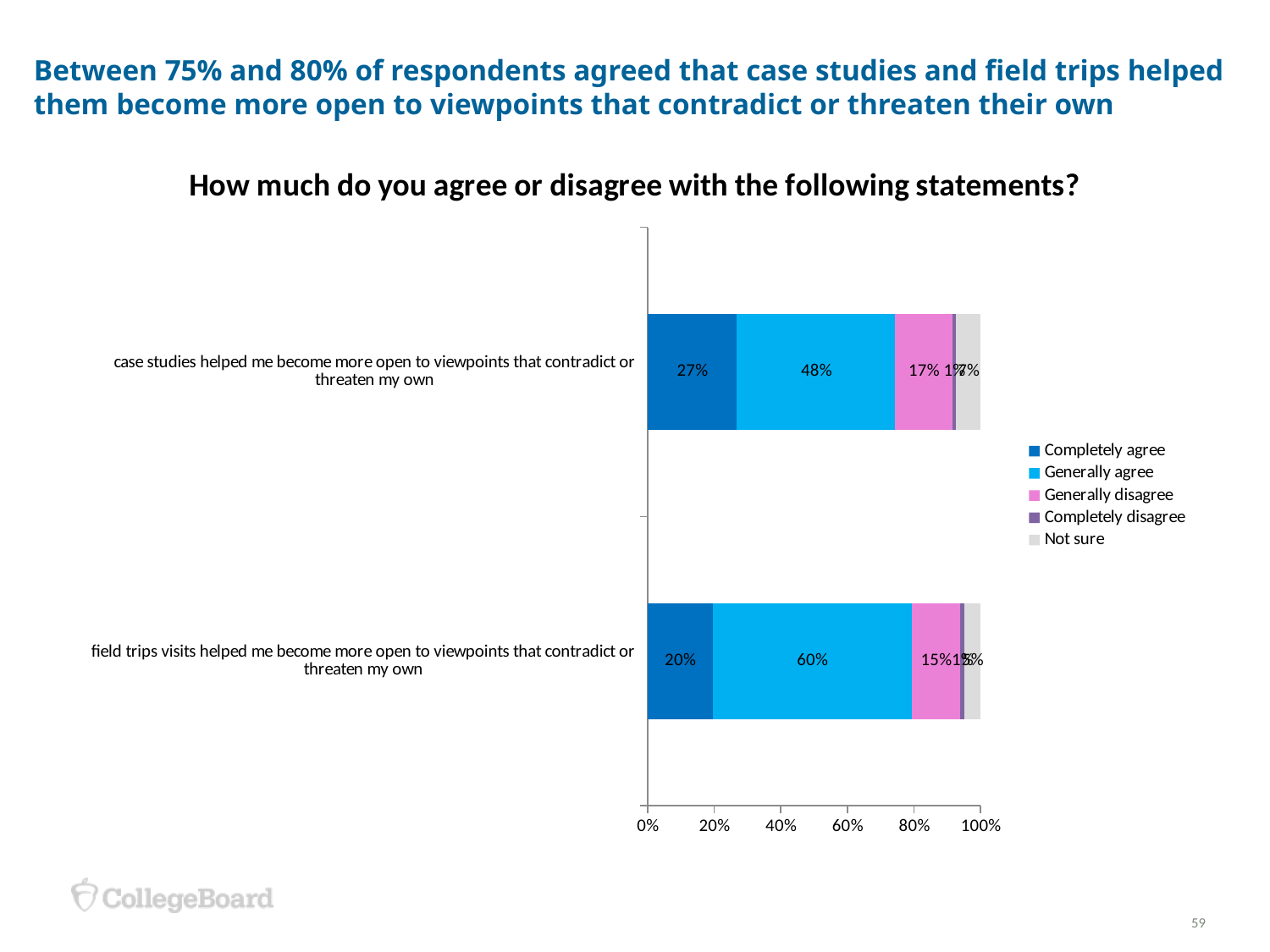
What type of chart is shown on the slide? Stacked bar chart What is the difference in percentage points between the 'Generally agree' shares for field trips visits and case studies? 12 percentage points What percentage of respondents generally disagreed that case studies helped them become more open to contradicting viewpoints? 17% What percentage of respondents completely agreed that field trips visits helped them become more open to contradicting viewpoints? 20% What percentage of respondents generally disagreed that field trips visits helped them become more open to contradicting viewpoints? 15% Which statement has the larger 'Generally agree' share: case studies or field trips visits? field trips visits Which statement has the larger 'Completely agree' share: case studies or field trips visits? case studies What percentage of respondents completely agreed that case studies helped them become more open to viewpoints that contradict or threaten their own? 27% What percentage of respondents generally agreed that field trips visits helped them become more open to contradicting viewpoints? 60% How many response categories does the legend list? 5 How many statements (bars) are shown in the chart? 2 What percentage of respondents generally agreed that case studies helped them become more open to contradicting viewpoints? 48%